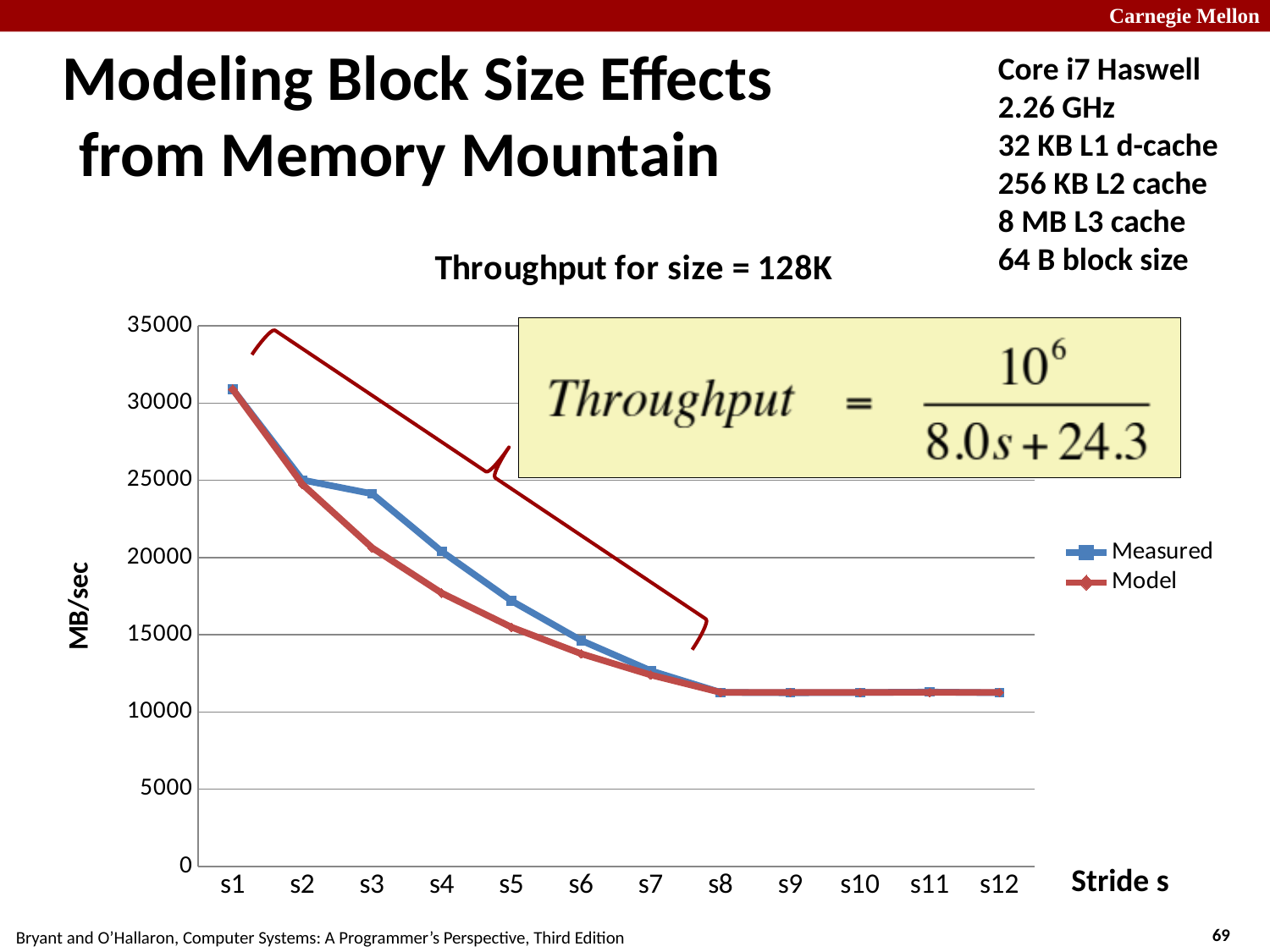
Is the Measured value at s2 greater or less than 20000? greater Is the Model value at s4 greater or less than 20000? less Do the Measured values rise or fall as the stride increases from s1 to s8? fall What are the two series named in the chart's legend? Measured and Model At stride s3, which series has the larger value, Measured or Model? Measured Is the Measured value at s1 greater or less than 25000? greater How many stride values are plotted along the x axis? 12 What is the title of the chart? Throughput for size = 128K How many series does the chart's legend list? 2 At which stride is the Measured throughput highest? s1 What kind of chart is shown on the slide? line chart